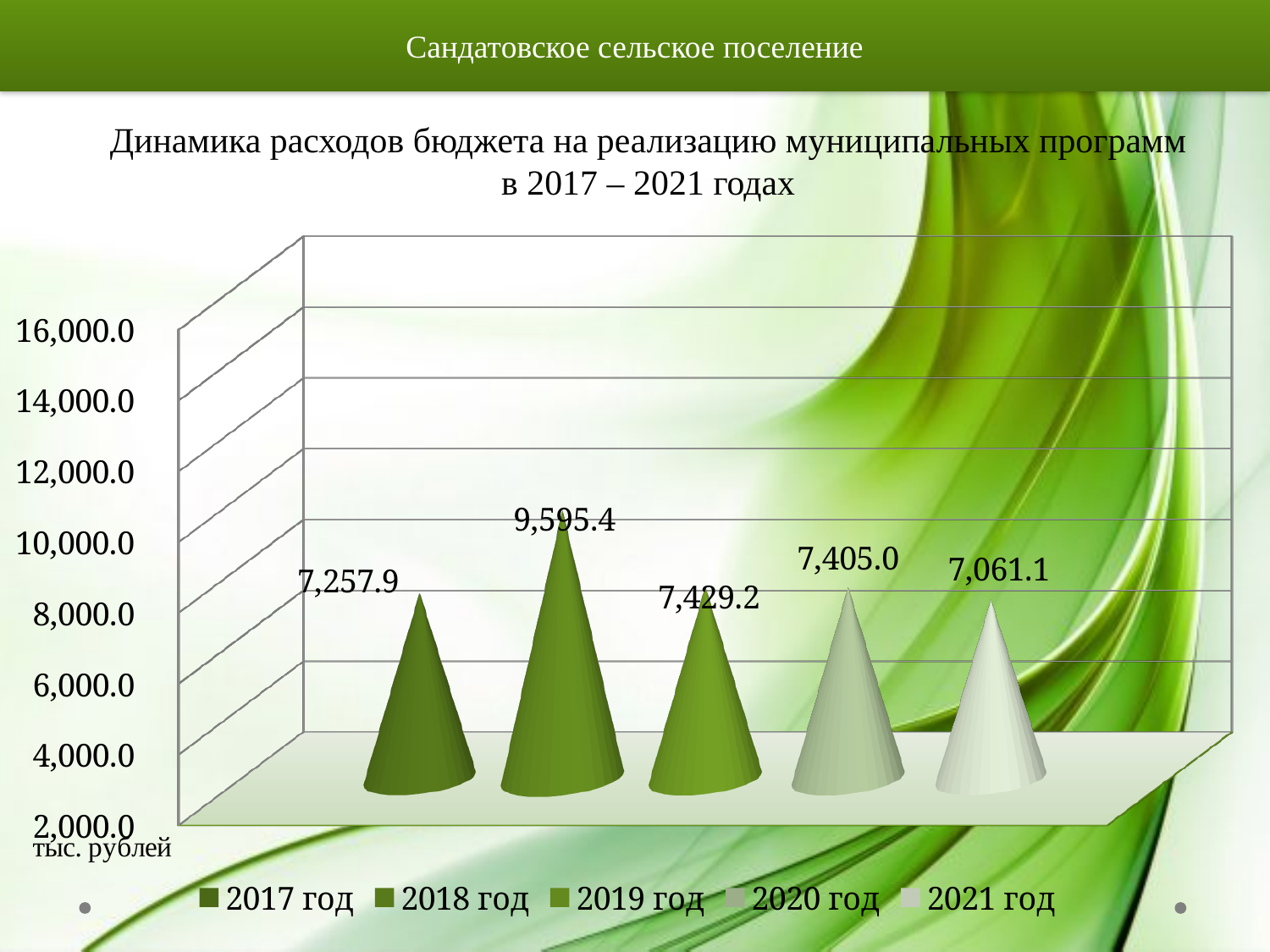
Which year has the lowest value? 2021 год What unit is indicated below the vertical axis of the chart? тыс. рублей What is the difference between the values for 2018 год and 2017 год? 2,337.5 What is the value for 2017 год? 7,257.9 What is the difference between the values for 2017 год and 2021 год? 196.8 What is the value for 2018 год? 9,595.4 How many series does the legend list? 5 Which is larger, the value for 2019 год or the value for 2020 год? 2019 год What is the value for 2021 год? 7,061.1 What kind of chart is shown on the slide? bar chart Which year has the highest value? 2018 год Is the value for 2018 год greater or less than 8,000.0? greater